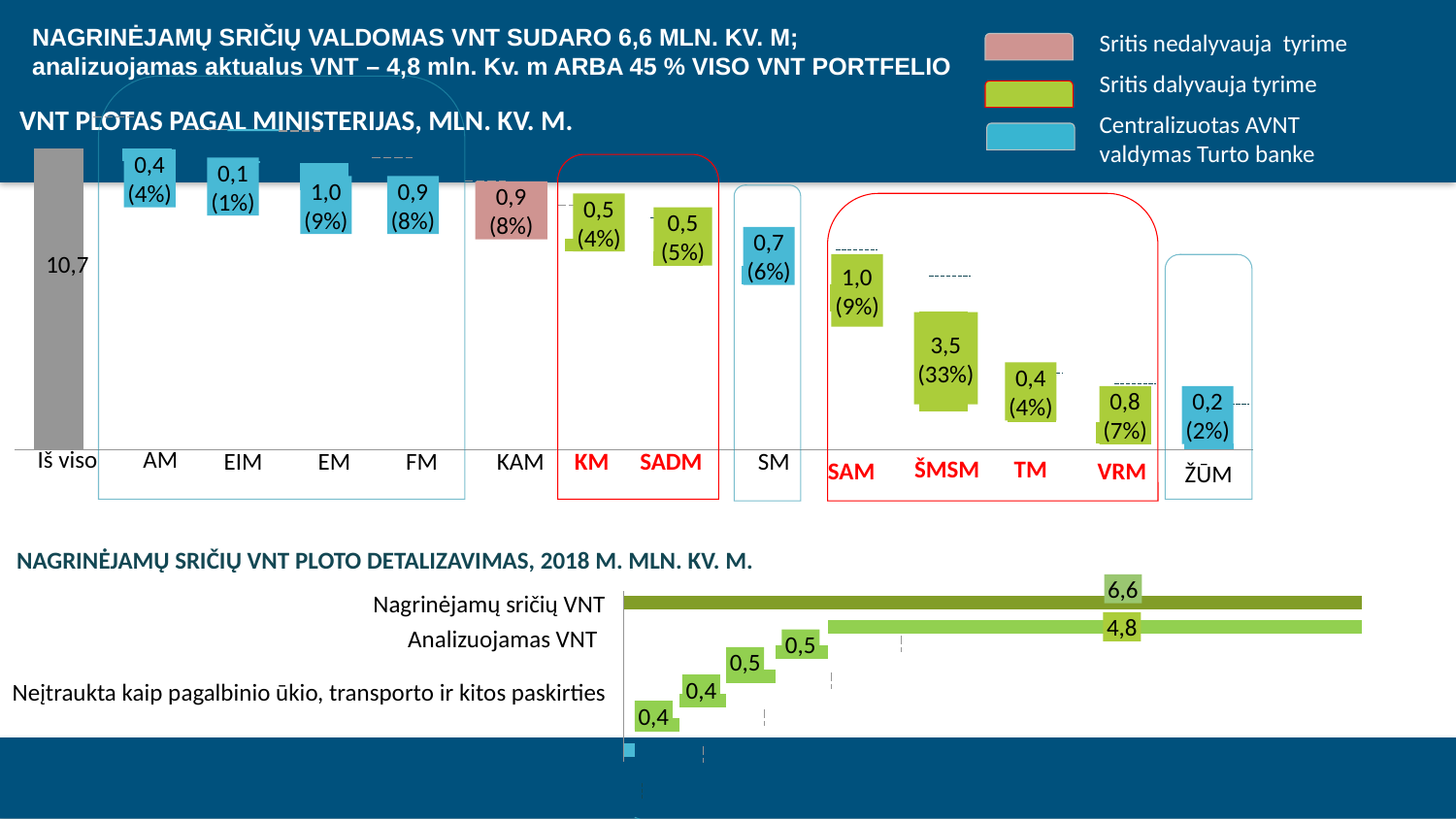
In the chart 'VNT PLOTAS PAGAL MINISTERIJAS, MLN. KV. M.', which is larger, the value for SM or the value for TM? SM In the chart 'VNT PLOTAS PAGAL MINISTERIJAS, MLN. KV. M.', which ministry has the largest value? ŠMSM In the chart 'VNT PLOTAS PAGAL MINISTERIJAS, MLN. KV. M.', what is the value for ŠMSM? 3,5 In the chart 'VNT PLOTAS PAGAL MINISTERIJAS, MLN. KV. M.', what is the difference between the values for ŠMSM and SAM? 2,5 How many entries does the legend in the top right of the slide list? 3 In the bottom chart 'NAGRINĖJAMŲ SRIČIŲ VNT PLOTO DETALIZAVIMAS, 2018 M. MLN. KV. M.', what is the value for 'Analizuojamas VNT'? 4,8 In the chart 'VNT PLOTAS PAGAL MINISTERIJAS, MLN. KV. M.', how many ministries are shown on the x axis, excluding 'Iš viso'? 13 In the chart 'VNT PLOTAS PAGAL MINISTERIJAS, MLN. KV. M.', what is the value for 'Iš viso'? 10,7 What type of chart is 'VNT PLOTAS PAGAL MINISTERIJAS, MLN. KV. M.'? Bar chart In the chart 'VNT PLOTAS PAGAL MINISTERIJAS, MLN. KV. M.', what percentage share is shown for VRM? 7% In the chart 'VNT PLOTAS PAGAL MINISTERIJAS, MLN. KV. M.', which ministry has the smallest value? EIM In the bottom chart 'NAGRINĖJAMŲ SRIČIŲ VNT PLOTO DETALIZAVIMAS, 2018 M. MLN. KV. M.', what is the difference between 'Nagrinėjamų sričių VNT' and 'Analizuojamas VNT'? 1,8